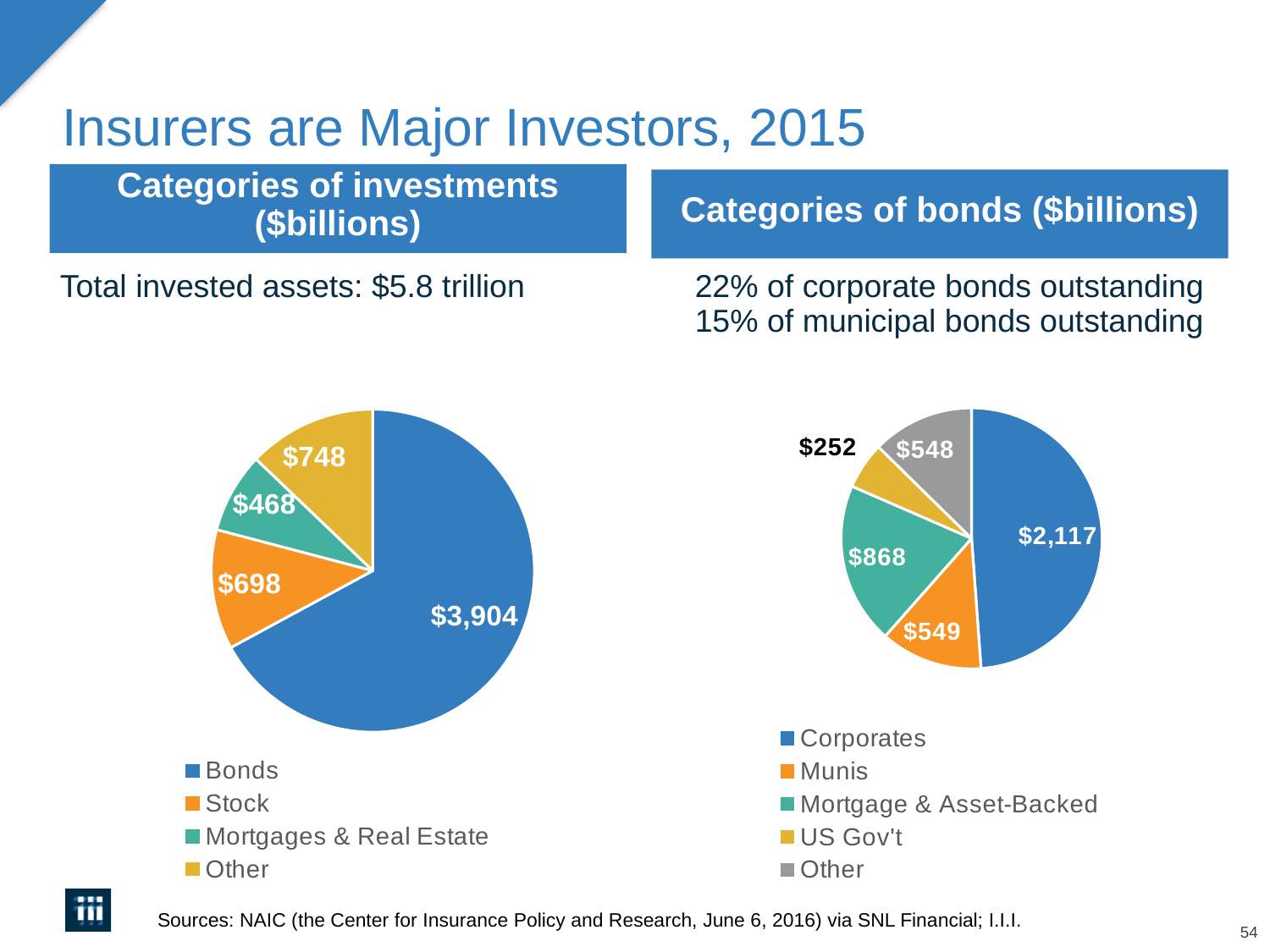
In the Categories of investments ($billions) chart, which category has the smallest value? Mortgages & Real Estate In the Categories of investments ($billions) chart, which is larger, Stock or Other? Other In the Categories of bonds ($billions) chart, what is the value for Corporates? $2,117 What type of chart is used for the Categories of investments ($billions) chart? pie chart In the Categories of bonds ($billions) chart, what is the difference between Corporates and Mortgage & Asset-Backed? $1,249 In the Categories of investments ($billions) chart, what is the value for Mortgages & Real Estate? $468 In the Categories of bonds ($billions) chart, which category has the largest value? Corporates How many categories does the legend of the Categories of investments ($billions) chart list? 4 In the Categories of bonds ($billions) chart, what is the value for US Gov't? $252 In the Categories of investments ($billions) chart, what is the value for Bonds? $3,904 How many categories does the legend of the Categories of bonds ($billions) chart list? 5 In the Categories of investments ($billions) chart, what is the difference between Bonds and Stock? $3,206